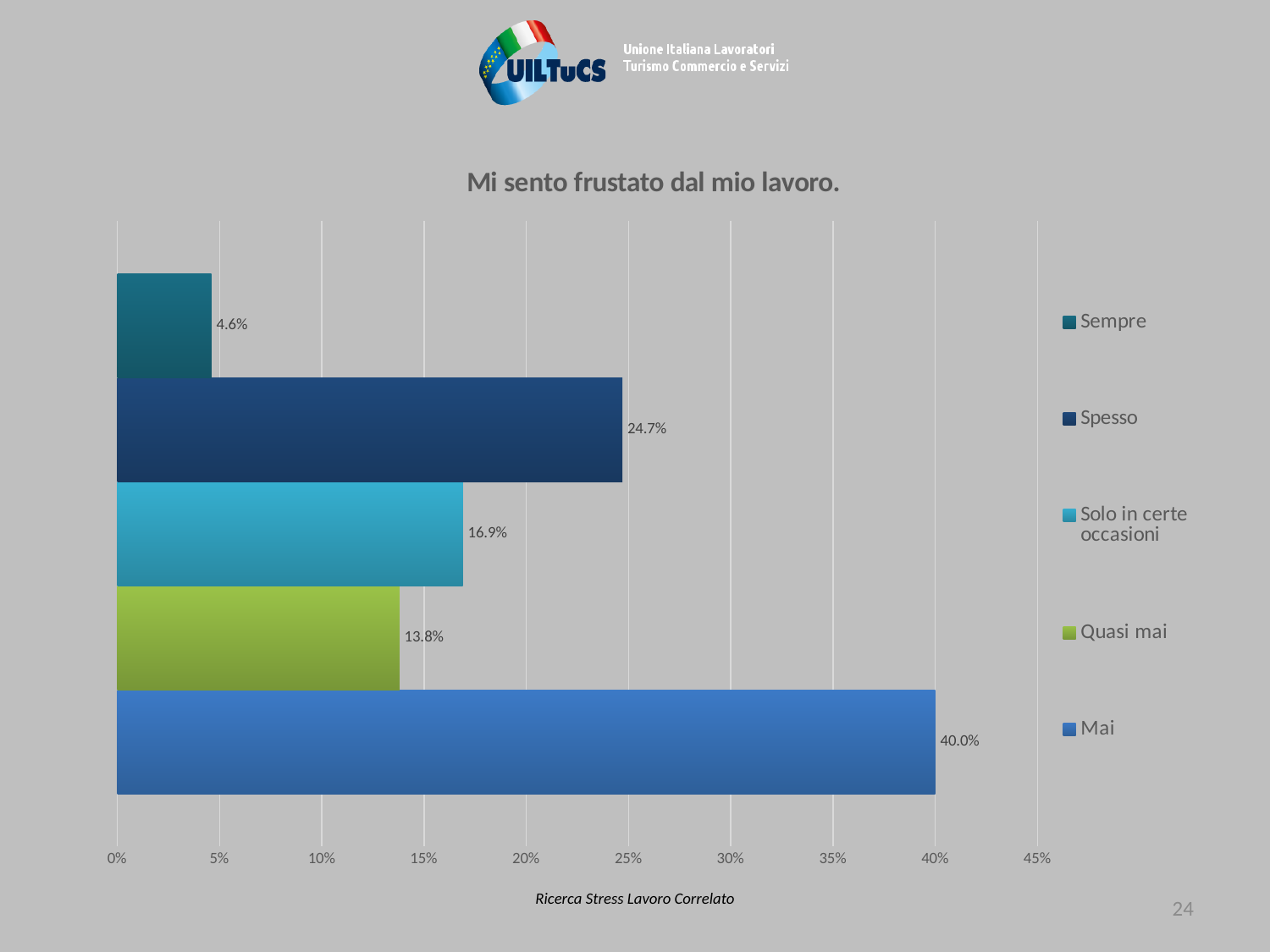
What is the value for Quasi mai? 13.8% What is the value for Spesso? 24.7% Which category has the highest value? Mai What is the difference between the values for Mai and Spesso? 15.3% Which is larger, the value for Solo in certe occasioni or the value for Quasi mai? Solo in certe occasioni How many categories are shown in the chart? 5 What is the value for Sempre? 4.6% What is the title of the chart? Mi sento frustato dal mio lavoro. What is the value for Mai? 40.0% What is the value for Solo in certe occasioni? 16.9% Which category has the lowest value? Sempre What kind of chart is shown on the slide? Bar chart